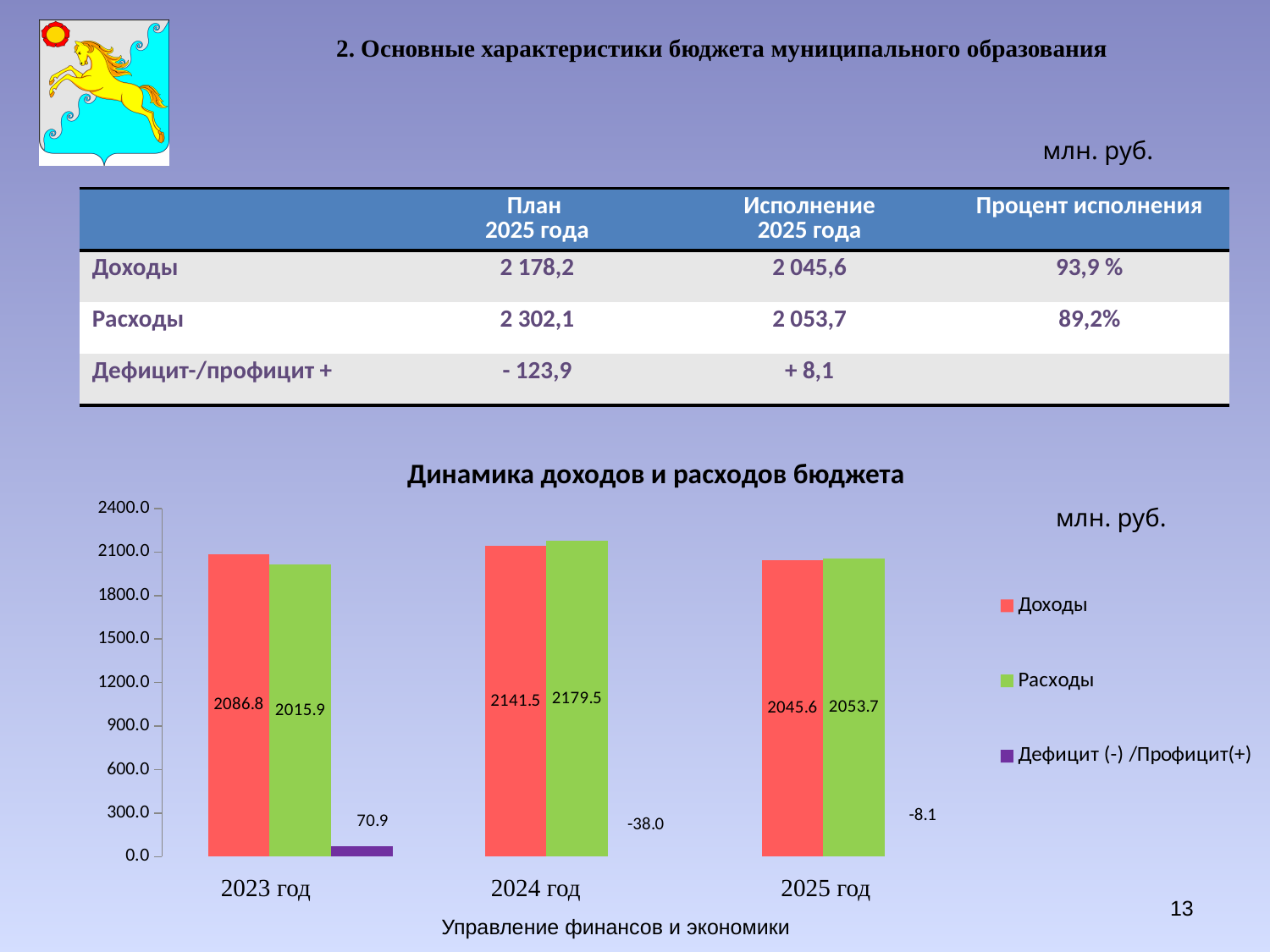
What is the difference between Расходы and Доходы for 2024 год? 38.0 How many years are shown on the x axis of the chart? 3 Which year has the lowest value for Расходы? 2023 год Which is larger for 2023 год, Доходы or Расходы? Доходы Which year has the highest value for Доходы? 2024 год What is the title of the chart? Динамика доходов и расходов бюджета How many series does the chart legend list? 3 What type of chart is shown on the slide? bar chart What is the value of Расходы for 2024 год? 2179.5 What is the value of Дефицит (-) /Профицит(+) for 2025 год? -8.1 Is the value of Доходы for 2025 год greater or less than 2100.0? less What is the value of Доходы for 2023 год? 2086.8